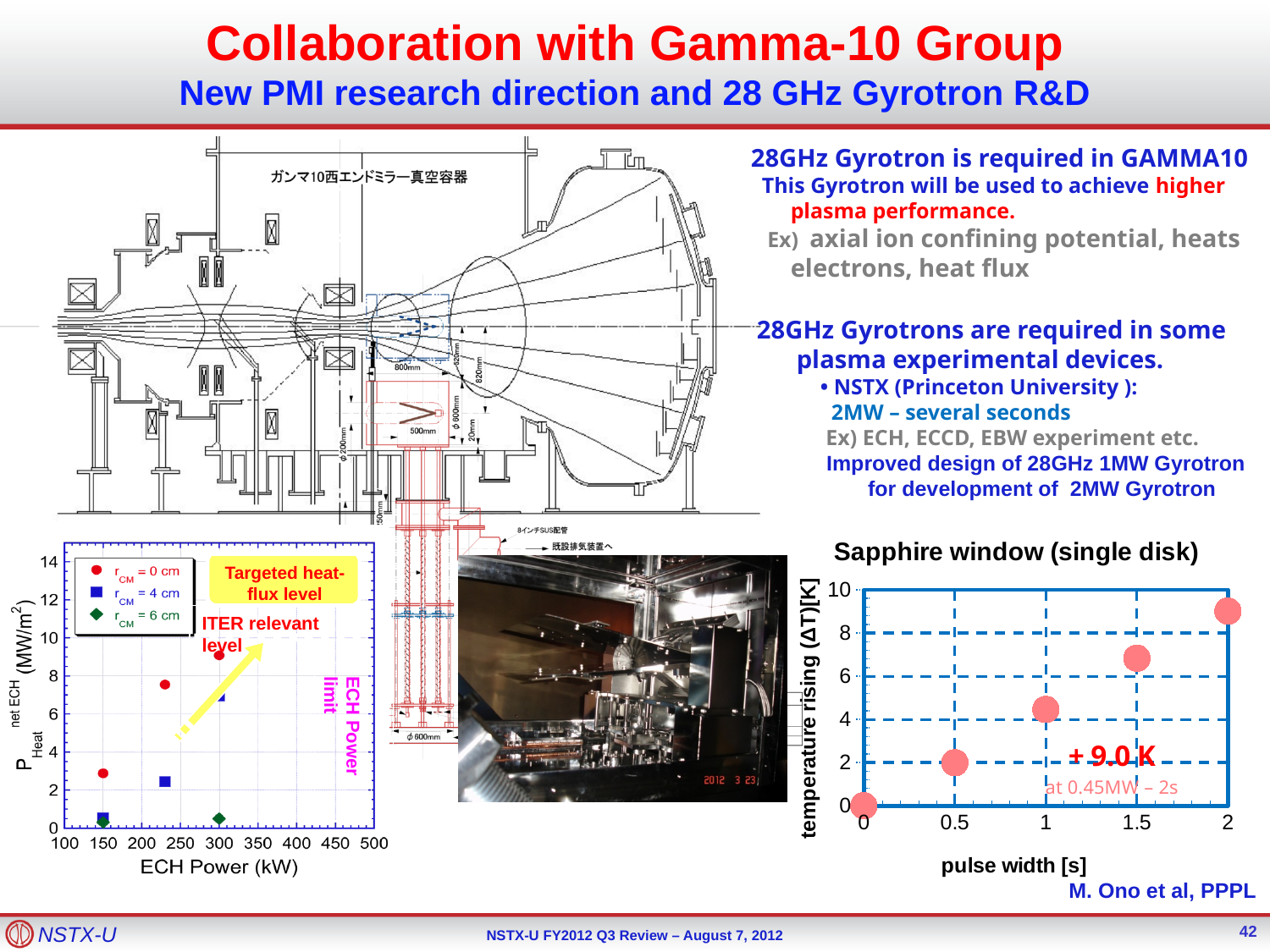
On the bottom-left chart (P_Heat vs ECH Power), how many series does the legend list? 3 On the 'Sapphire window (single disk)' chart, what temperature rise is annotated for the 2 s pulse at 0.45 MW? +9.0 K On the bottom-left chart (P_Heat vs ECH Power), does the r_CM = 0 cm series rise or fall as ECH power increases? rise On the 'Sapphire window (single disk)' chart, is the temperature rise at a pulse width of 1.5 s greater or less than 6? greater On the bottom-left chart (P_Heat vs ECH Power), which series has the highest heat flux at 300 kW? r_CM = 0 cm On the 'Sapphire window (single disk)' chart, at which pulse width is the temperature rise highest? 2 On the 'Sapphire window (single disk)' chart, does the temperature rise increase or decrease as pulse width increases? increase On the bottom-left chart (P_Heat vs ECH Power), what is the x-axis label? ECH Power (kW) On the bottom-left chart (P_Heat vs ECH Power), is the value for r_CM = 6 cm at 300 kW greater or less than 2? less On the bottom-left chart (P_Heat vs ECH Power), is the value for r_CM = 0 cm at 300 kW greater or less than 8? greater On the 'Sapphire window (single disk)' chart, how many data points are plotted? 5 On the bottom-left chart (P_Heat vs ECH Power), what kind of chart is it? scatter plot